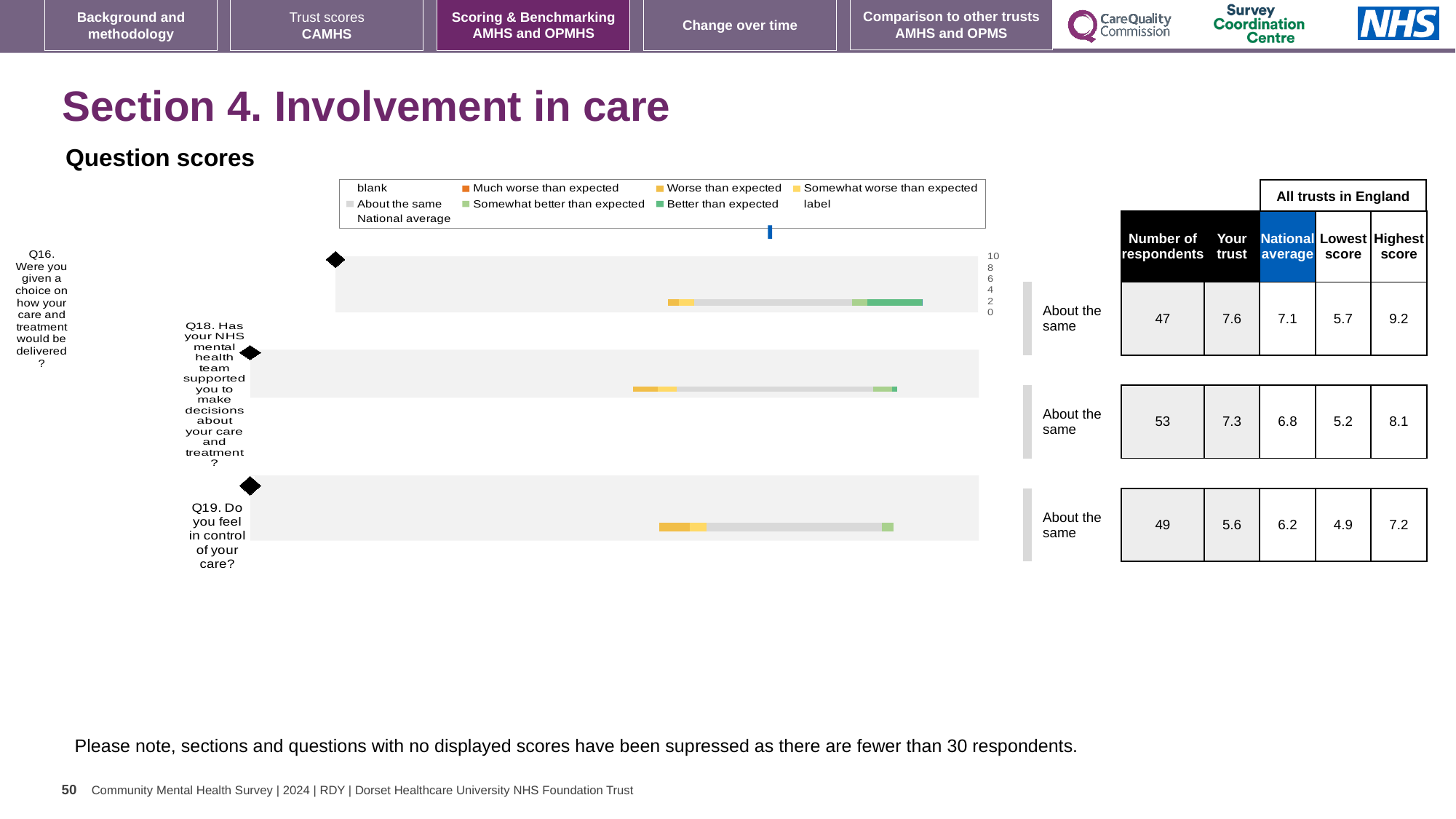
How many respondents answered Q18? 53 What is the lowest score across all trusts in England for Q19 (Do you feel in control of your care?)? 4.9 What is the difference between the highest score and the lowest score for Q19? 2.3 What kind of chart is used for the Question scores? bar chart What is the difference between the 'Your trust' score and the national average for Q16? 0.5 What benchmark category label is shown next to each of the three questions? About the same For Q19, which is larger: the 'Your trust' score or the national average? National average Which question has the highest 'Your trust' score? Q16 Which question has the lowest 'Your trust' score? Q19 What is the national average score for Q18 (Has your NHS mental health team supported you to make decisions about your care and treatment?)? 6.8 What is the 'Your trust' score for Q16 (Were you given a choice on how your care and treatment would be delivered?)? 7.6 How many survey questions are plotted in the Question scores chart? 3